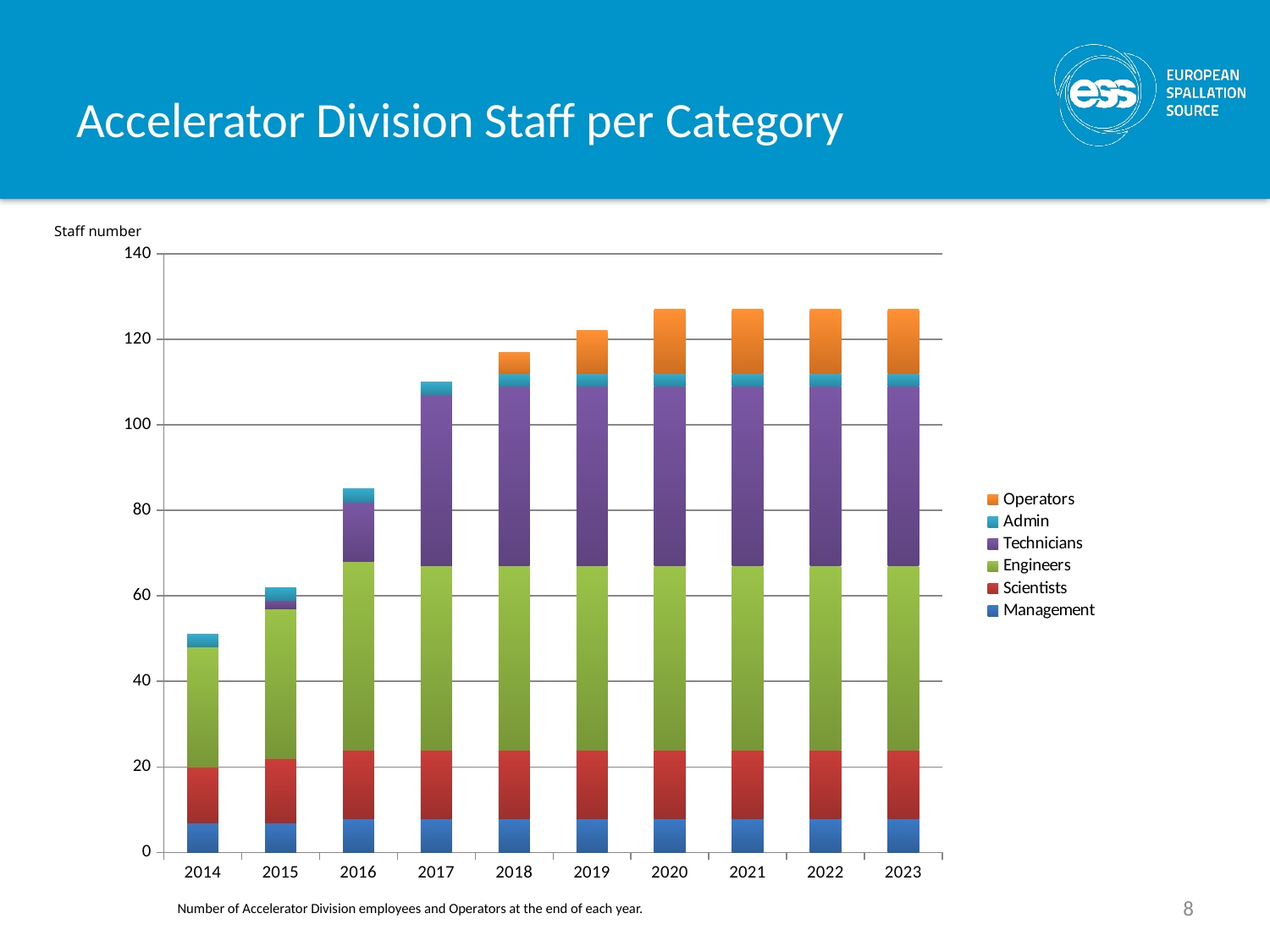
Do the total staff numbers rise or fall from 2014 to 2019? rise Which year has the lowest total staff number in the chart? 2014 What kind of chart is shown on the slide? stacked bar chart Is the total staff number for 2023 greater or less than 120? greater Which year has a larger total staff number, 2014 or 2016? 2016 How many series does the chart's legend list? 6 How many years are shown on the x axis of the chart? 10 What is the title of the chart on the slide? Accelerator Division Staff per Category Is the total staff number for 2014 greater or less than 60? less Is the total staff number for 2016 greater or less than 80? greater Which series is shown in orange in the chart's legend? Operators